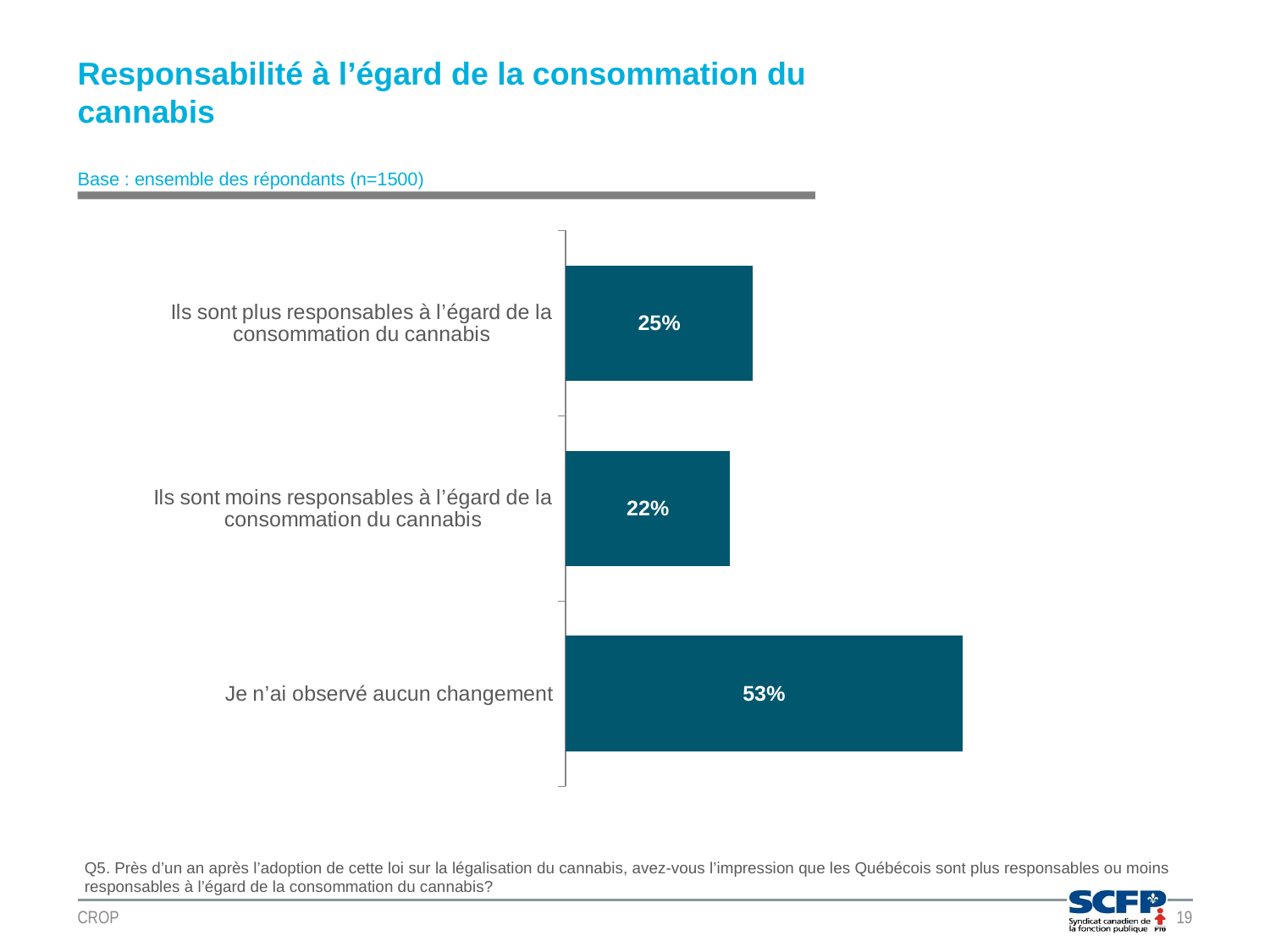
Which category has the highest value? Je n'ai observé aucun changement What is the title of the slide? Responsabilité à l'égard de la consommation du cannabis What is the base (sample size) stated for the chart? n=1500 Which category has the lowest value? Ils sont moins responsables à l'égard de la consommation du cannabis What percentage of respondents said "Je n'ai observé aucun changement"? 53% What is the value for "Ils sont moins responsables à l'égard de la consommation du cannabis"? 22% What is the difference between "Ils sont plus responsables" and "Ils sont moins responsables"? 3 percentage points What is the value for "Ils sont plus responsables à l'égard de la consommation du cannabis"? 25% What is the difference between "Je n'ai observé aucun changement" and "Ils sont plus responsables à l'égard de la consommation du cannabis"? 28 percentage points Which is larger: the value for "Ils sont plus responsables" or "Ils sont moins responsables"? Ils sont plus responsables What kind of chart is shown on the slide? Bar chart How many categories are shown in the chart? 3